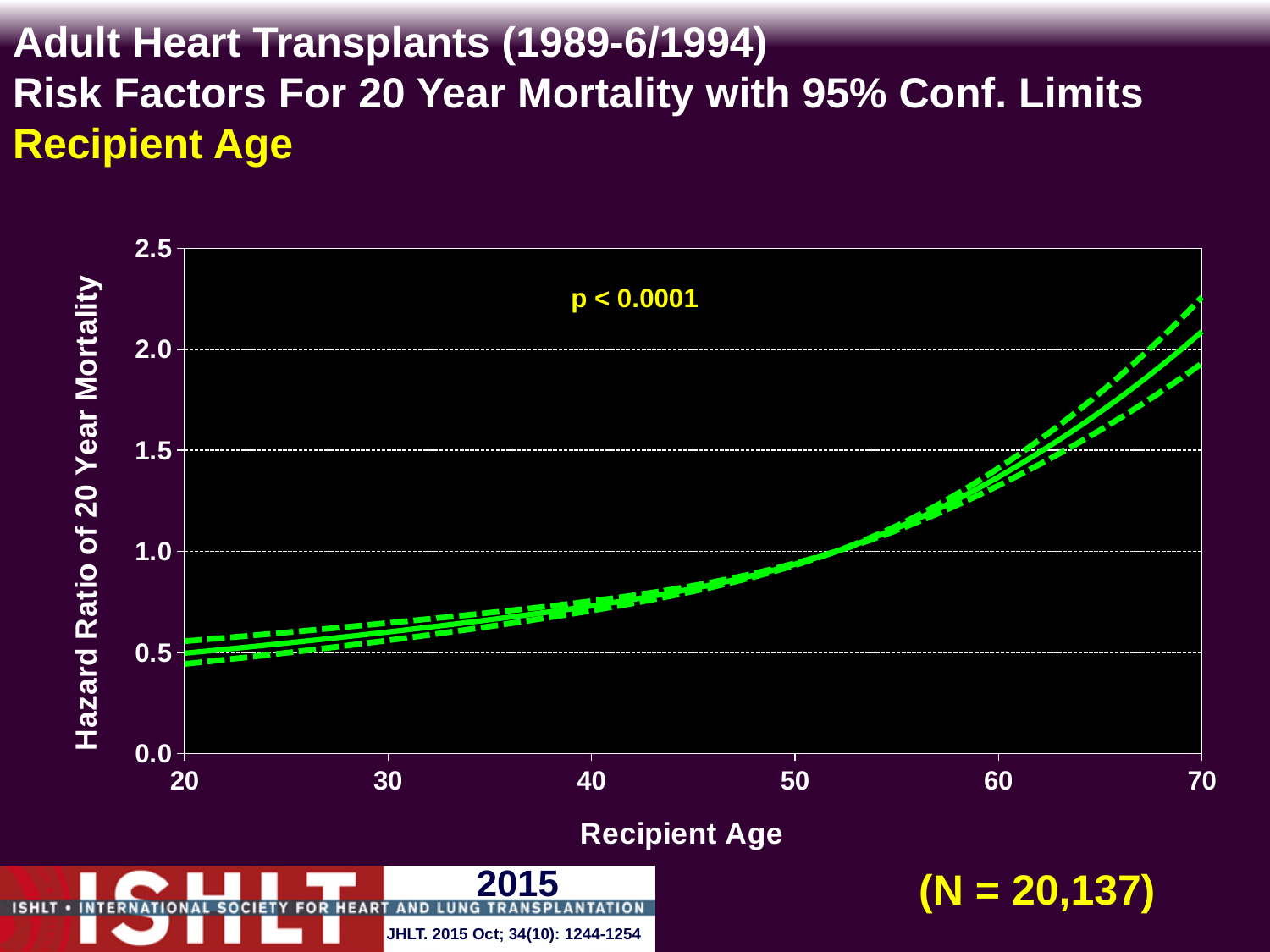
Is the hazard ratio for a recipient age of 30 greater or less than 1.0? less Is the hazard ratio for a recipient age of 60 greater or less than 1.0? greater Does the hazard ratio of 20 year mortality rise or fall as recipient age increases from 20 to 70? rise Is the hazard ratio for a recipient age of 40 greater or less than 1.0? less At which recipient age shown on the x axis is the hazard ratio lowest? 20 Which has the larger hazard ratio, a recipient age of 30 or a recipient age of 60? 60 What kind of chart is shown on the slide? line chart At which recipient age shown on the x axis is the hazard ratio highest? 70 What p-value is printed on the chart? p < 0.0001 What is the sample size N shown on the slide? N = 20,137